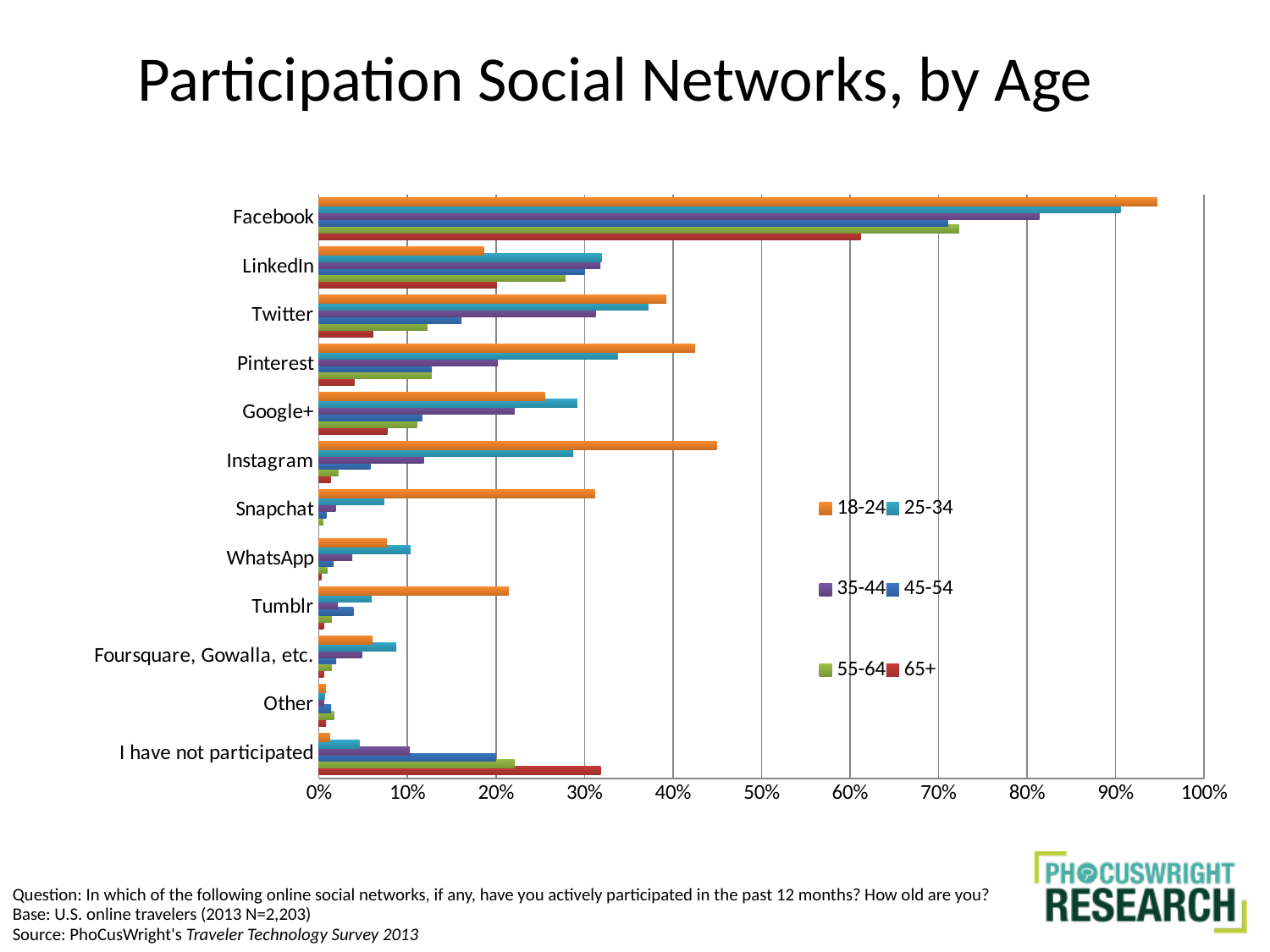
Is the value for Facebook in the 18-24 age group greater or less than 90%? greater Which social network has the highest participation for the 65+ age group? Facebook Is the value for Instagram in the 18-24 age group greater or less than 40%? greater What is the title of the chart? Participation Social Networks, by Age Is the value for Facebook in the 65+ age group greater or less than 70%? less How many age groups does the legend list? 6 For Instagram, which age group has the larger value: 18-24 or 25-34? 18-24 What type of chart is shown on the slide? bar chart For Google+, which age group has the larger value: 18-24 or 25-34? 25-34 Which social network has the highest participation for the 18-24 age group? Facebook How many social network categories are listed on the chart? 12